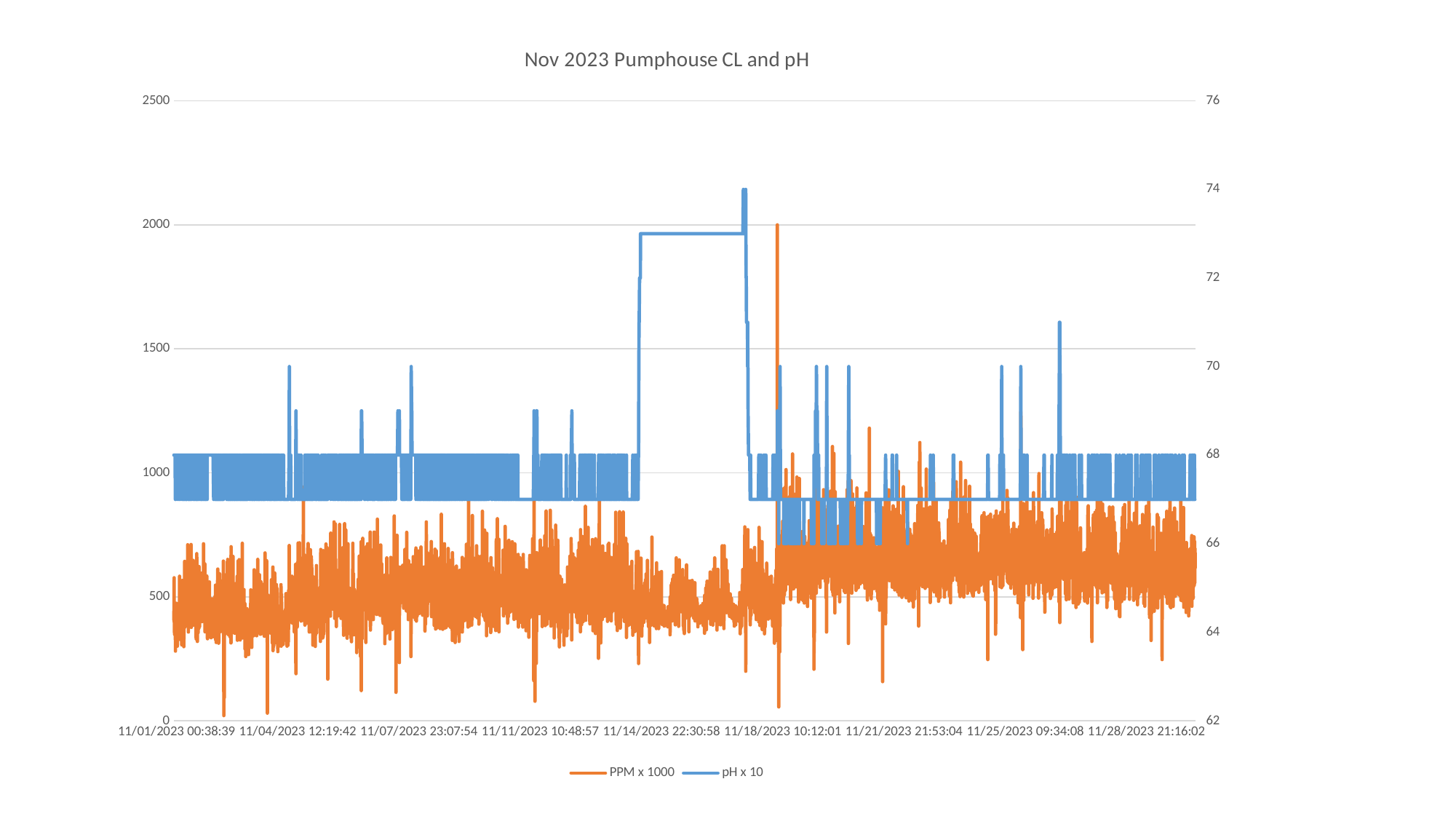
Is the pH x 10 value at the start of the chart on 11/01/2023 greater or less than 66 on the right axis? greater What kind of chart is shown on the slide? line chart Does the typical level of the PPM x 1000 series rise or fall from the start of November to the end of November? rise What is the title of the chart? Nov 2023 Pumphouse CL and pH Which colour is used for the pH x 10 series? blue How many series does the legend list? 2 Is the PPM x 1000 value at the start of the chart on 11/01/2023 greater or less than 1000 on the left axis? less Is the pH x 10 value during the plateau between 11/14/2023 and 11/18/2023 greater or less than 72 on the right axis? greater What is the maximum value shown on the left vertical axis? 2500 Does the baseline level of the pH x 10 series rise or fall after 11/18/2023 compared with before 11/14/2023? fall How many date labels are shown along the x axis? 9